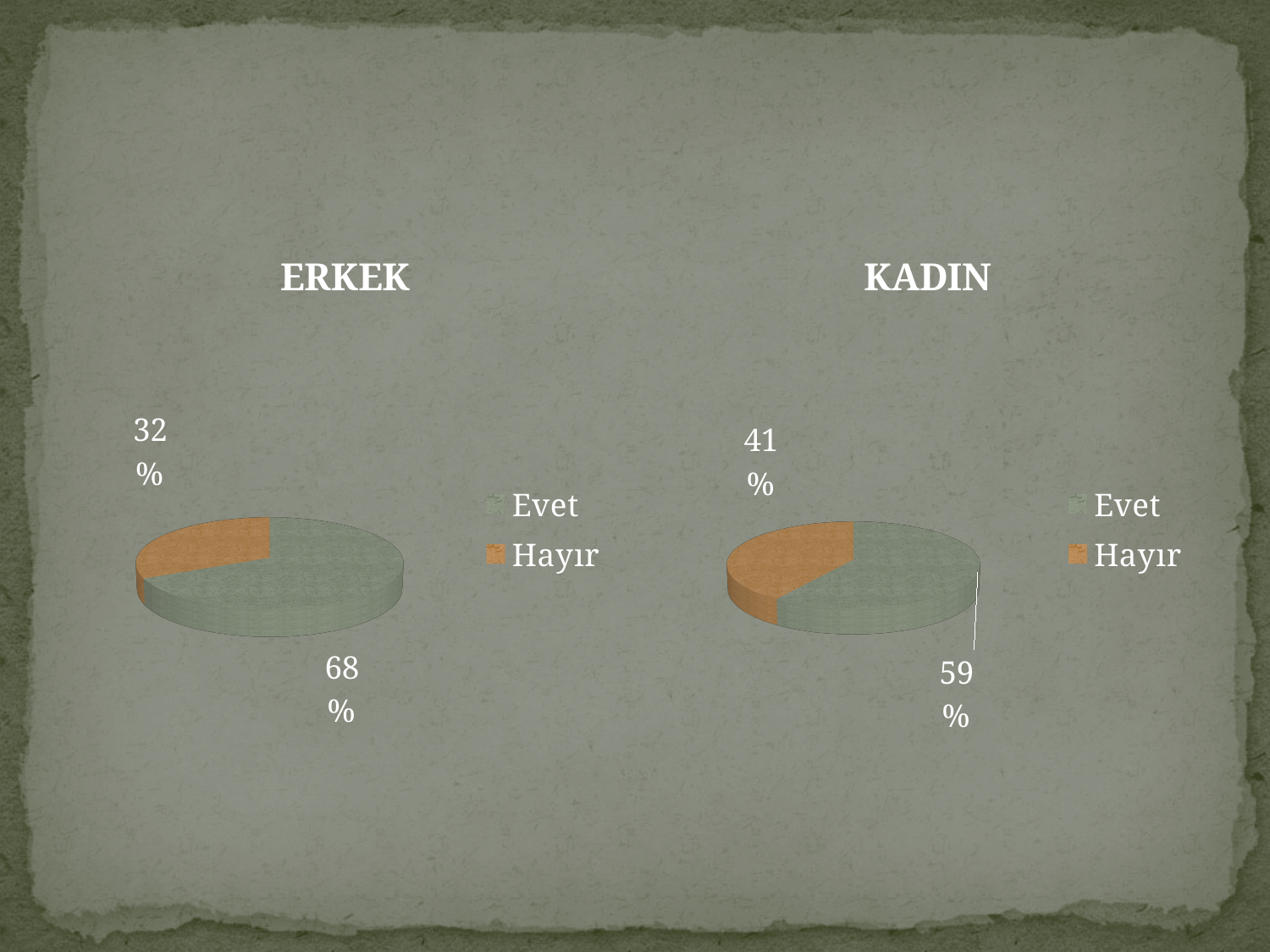
In the ERKEK chart, which slice is the largest? Evet How many slices does the ERKEK pie chart have? 2 In the ERKEK chart, what is the difference between the Evet and Hayır shares? 36% In the KADIN chart, what share of the pie is Hayır? 41% In the KADIN chart, which slice is the smallest? Hayır Which chart has the larger Evet share, ERKEK or KADIN? ERKEK What are the legend entries in the KADIN chart? Evet, Hayır In the ERKEK chart, what share of the pie is Hayır? 32% What kind of chart is the KADIN chart? Pie chart In the KADIN chart, what share of the pie is Evet? 59% In the KADIN chart, what is the difference between the Evet and Hayır shares? 18%